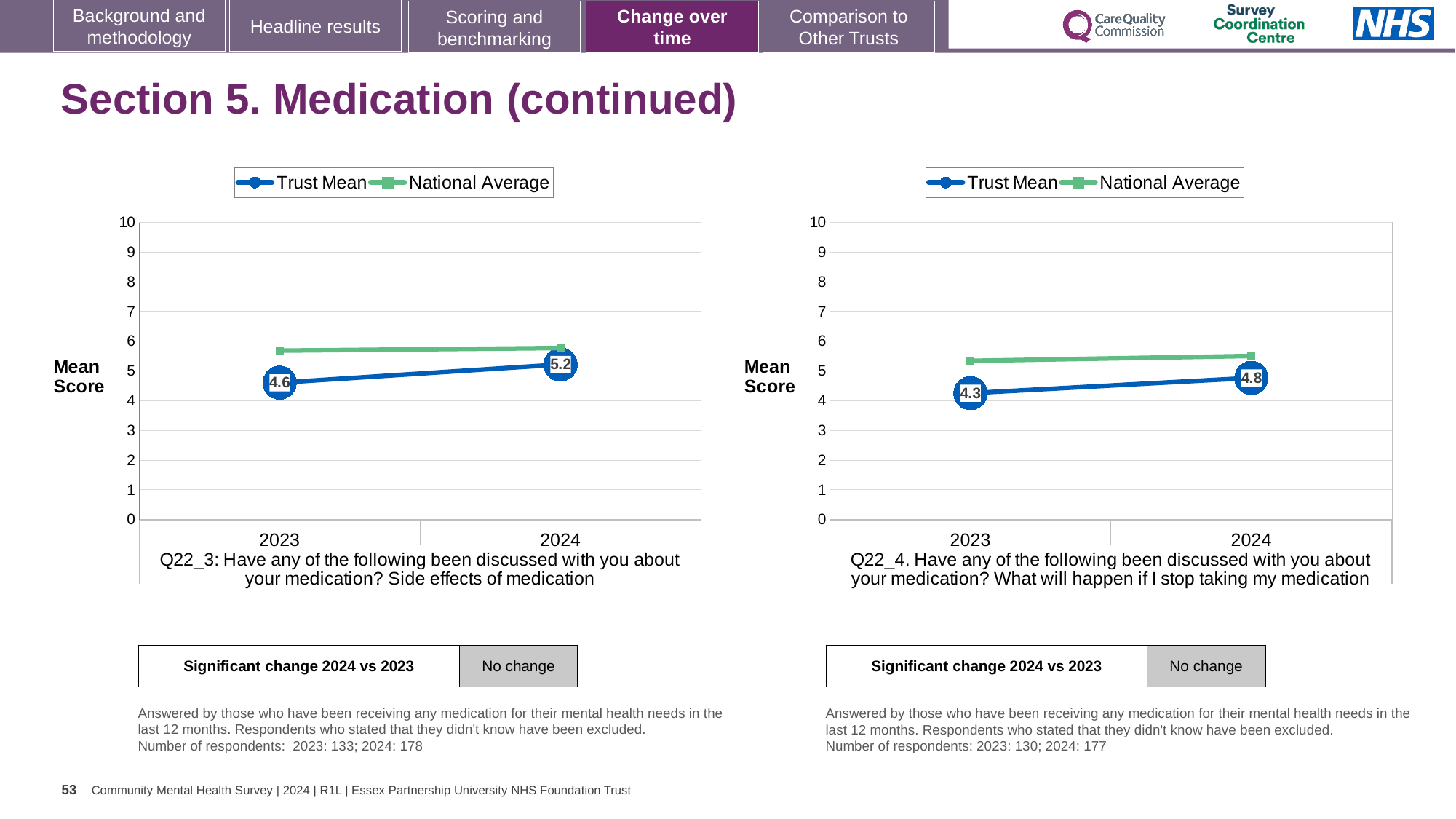
In the left chart (Q22_3, side effects of medication), what is the Trust Mean for 2024? 5.2 In the left chart (Q22_3), does the Trust Mean rise or fall from 2023 to 2024? rise How many series does the legend of the right chart (Q22_4) list? 2 In the right chart (Q22_4, what will happen if I stop taking my medication), what is the Trust Mean for 2023? 4.3 In the right chart (Q22_4), is the National Average for 2023 greater or less than 5? greater In the left chart (Q22_3, side effects of medication), what is the Trust Mean for 2023? 4.6 How many years are plotted on the x axis of the right chart (Q22_4)? 2 In the left chart (Q22_3), which series is higher in 2023, Trust Mean or National Average? National Average What type of chart is the left chart (Q22_3)? line chart In the right chart (Q22_4), what is the difference between the Trust Mean in 2024 and in 2023? 0.5 In the left chart (Q22_3), by how much did the Trust Mean change from 2023 to 2024? 0.6 In the right chart (Q22_4, what will happen if I stop taking my medication), what is the Trust Mean for 2024? 4.8